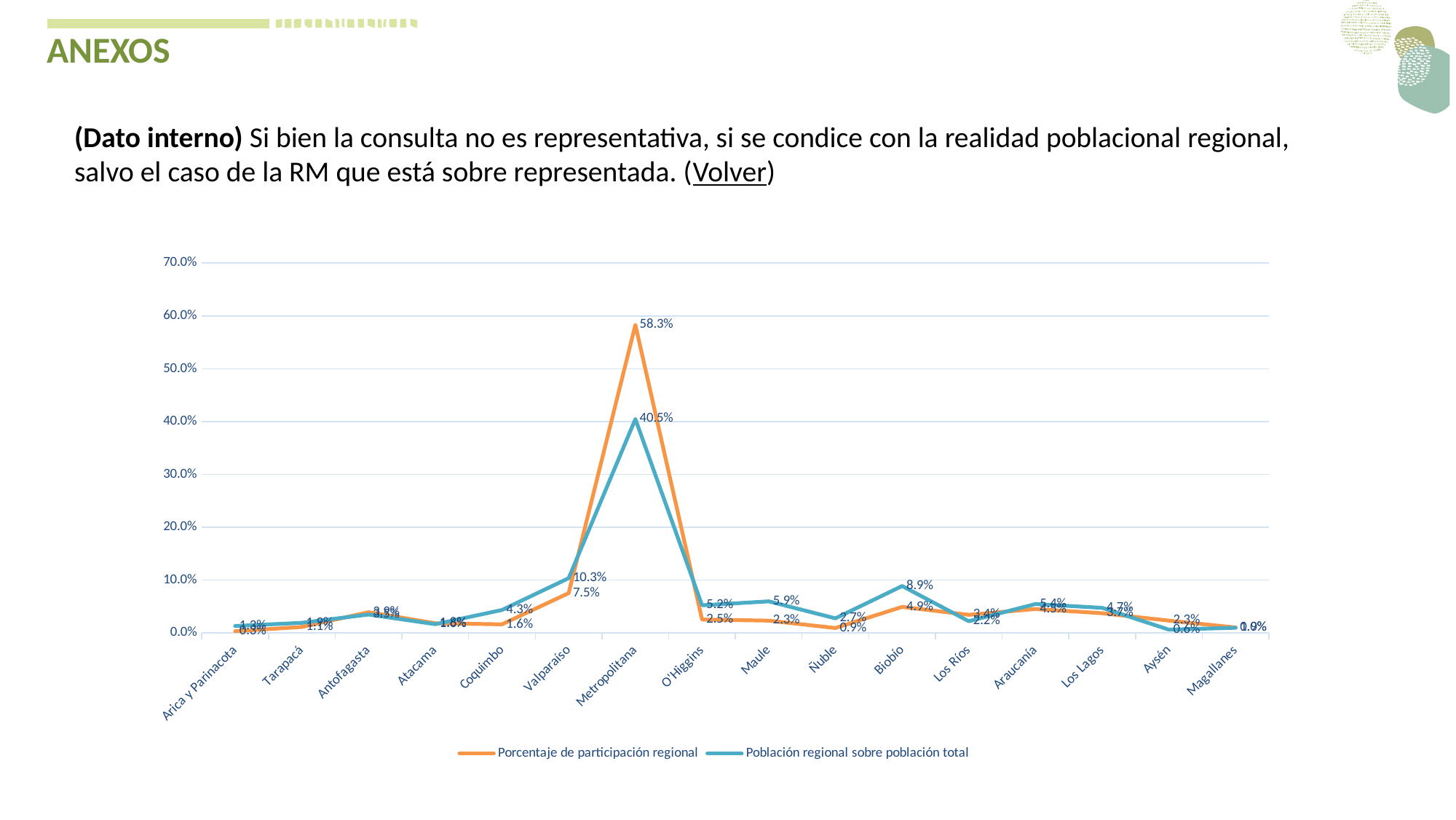
How many series does the chart legend list? 2 For Valparaíso, which series has the larger value: 'Porcentaje de participación regional' or 'Población regional sobre población total'? Población regional sobre población total What is the value of 'Población regional sobre población total' for Metropolitana? 40.5% What is the difference between 'Porcentaje de participación regional' and 'Población regional sobre población total' for Metropolitana? 17.8 percentage points What is the difference between 'Población regional sobre población total' and 'Porcentaje de participación regional' for Valparaíso? 2.8 percentage points Is the 'Porcentaje de participación regional' value for Metropolitana greater or less than 50.0%? greater Which region has the highest 'Porcentaje de participación regional'? Metropolitana What kind of chart is shown on the slide? Line chart What is the value of 'Porcentaje de participación regional' for Metropolitana? 58.3% How many regions are plotted along the x axis of the chart? 16 What is the value of 'Población regional sobre población total' for Biobío? 8.9% What colour is the line for 'Porcentaje de participación regional' in the chart? Orange